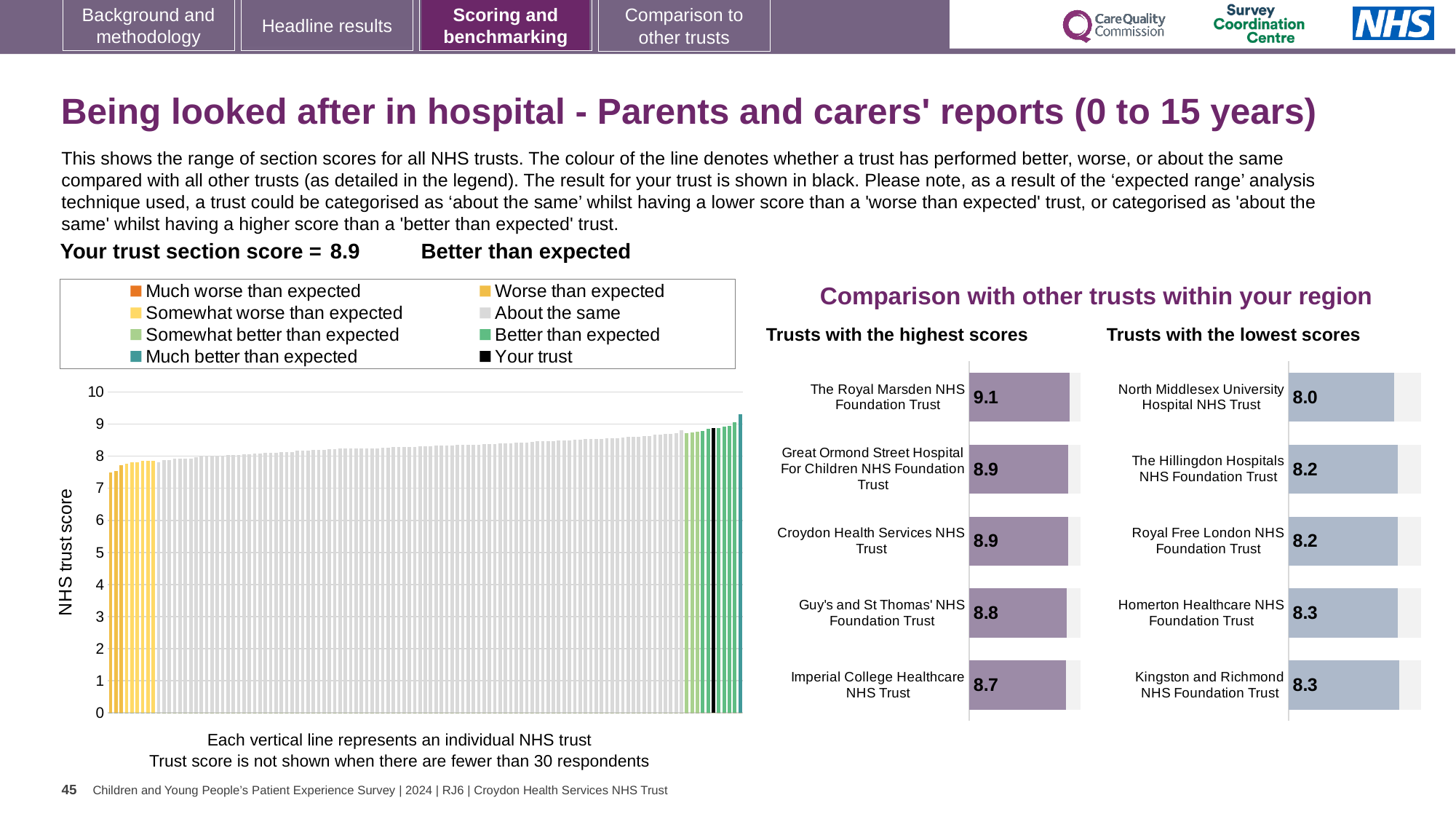
In the large chart on the left, is the value of the leftmost (lowest) bar greater or less than 8? less In the large chart on the left, do the bar values rise or fall from left to right? Rise In the 'Trusts with the highest scores' chart, what is the difference between the scores of The Royal Marsden NHS Foundation Trust and Imperial College Healthcare NHS Trust? 0.4 How many entries does the legend of the large chart on the left list? 8 In the 'Trusts with the highest scores' chart, which trust has the highest score? The Royal Marsden NHS Foundation Trust What type of chart is the large chart on the left showing NHS trust scores? Bar chart In the 'Trusts with the lowest scores' chart, which trust has the lowest score? North Middlesex University Hospital NHS Trust In the 'Trusts with the highest scores' chart, what is the score for The Royal Marsden NHS Foundation Trust? 9.1 In the 'Trusts with the highest scores' chart, what is the score for Imperial College Healthcare NHS Trust? 8.7 In the 'Trusts with the lowest scores' chart, what is the score for North Middlesex University Hospital NHS Trust? 8.0 How many trusts are listed in the 'Trusts with the lowest scores' chart? 5 In the 'Trusts with the lowest scores' chart, which has the larger score: The Hillingdon Hospitals NHS Foundation Trust or Homerton Healthcare NHS Foundation Trust? Homerton Healthcare NHS Foundation Trust